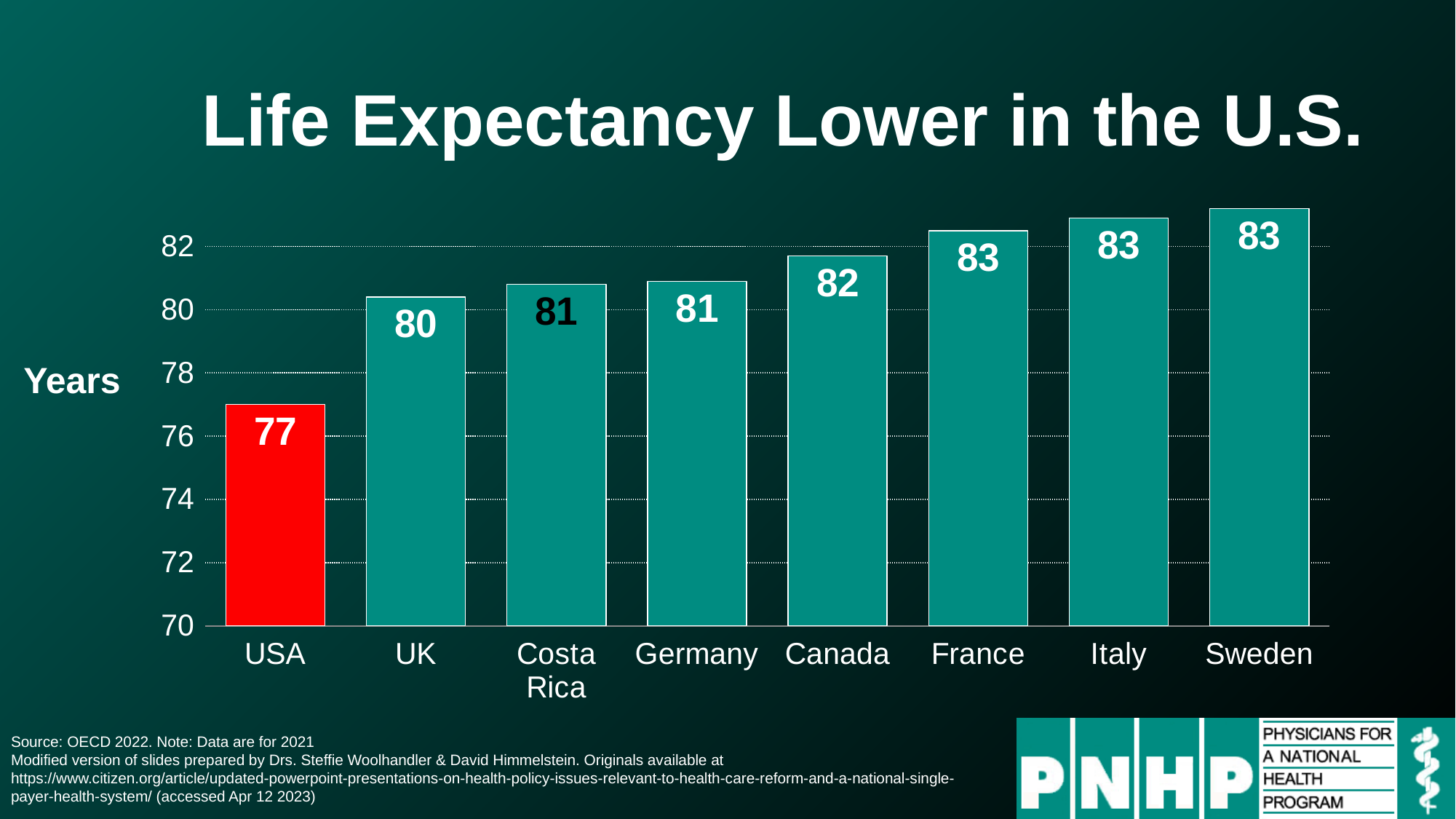
Which country's bar is coloured red? USA What is the difference between the values for Canada and the UK? 2 What is the life expectancy value shown for the USA? 77 How many countries are shown in the chart? 8 What value is shown for Canada? 82 Is the value for the USA greater or less than 78? less What is the difference between the values for Sweden and the USA? 6 Which country has the lowest life expectancy in the chart? USA What value is shown for the UK? 80 Do the values generally rise or fall from left to right across the countries? rise What kind of chart is shown on the slide? bar chart Which has a higher value, Canada or the UK? Canada